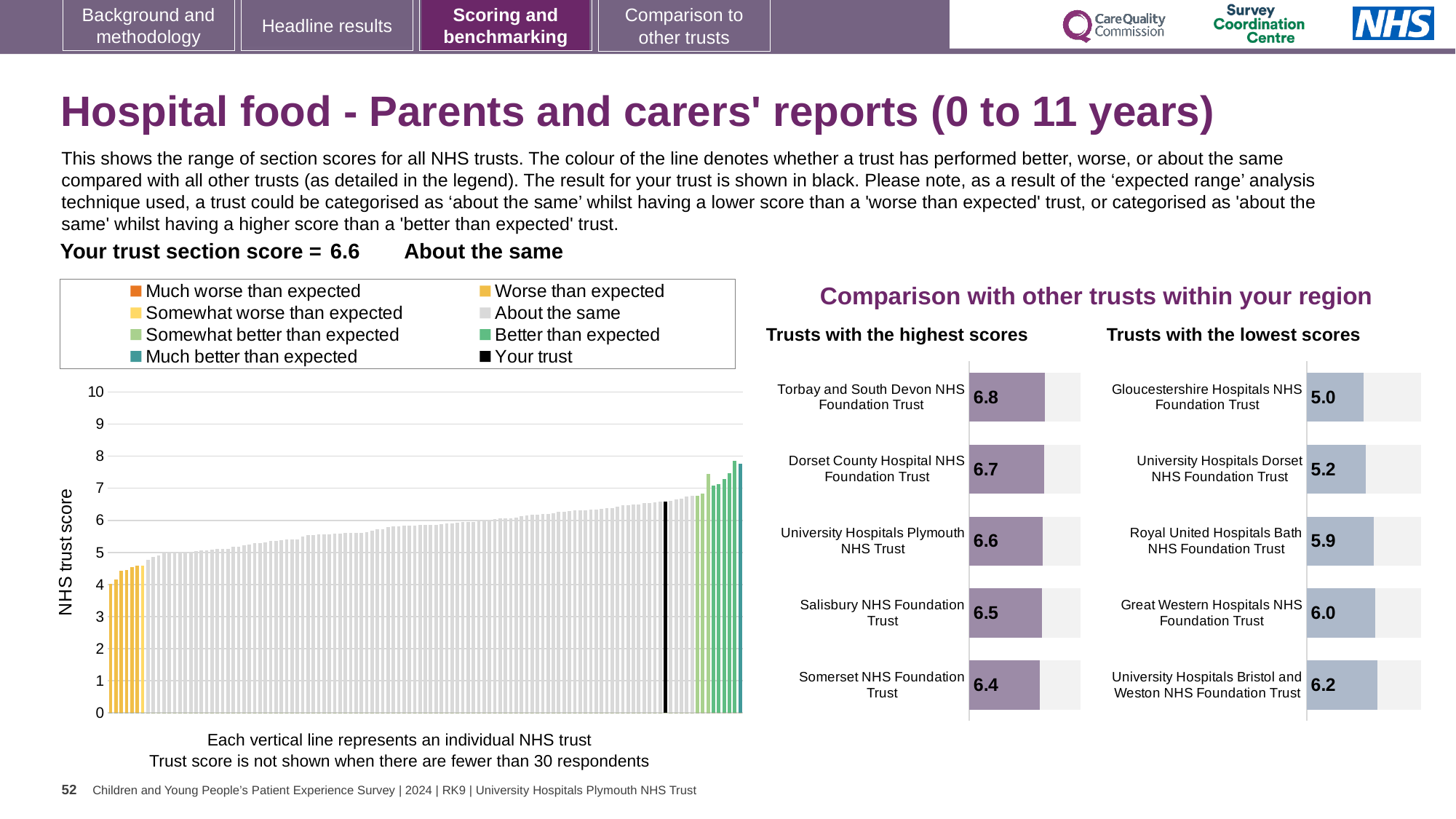
In the 'Trusts with the highest scores' chart, what is the difference between the scores of Torbay and South Devon NHS Foundation Trust and Somerset NHS Foundation Trust? 0.4 In the 'Trusts with the lowest scores' chart, which trust has the highest score? University Hospitals Bristol and Weston NHS Foundation Trust In the 'Trusts with the lowest scores' chart, which has the higher score: Royal United Hospitals Bath NHS Foundation Trust or Great Western Hospitals NHS Foundation Trust? Great Western Hospitals NHS Foundation Trust In the large chart on the left, is the value of the lowest bar greater or less than 5? less In the 'Trusts with the highest scores' chart, which trust has the lowest score? Somerset NHS Foundation Trust How many entries does the legend of the large chart on the left list? 8 How many trusts are shown in the 'Trusts with the lowest scores' chart? 5 In the 'Trusts with the highest scores' chart, what is the score for Torbay and South Devon NHS Foundation Trust? 6.8 In the 'Trusts with the lowest scores' chart, what is the difference between the scores of University Hospitals Bristol and Weston NHS Foundation Trust and Gloucestershire Hospitals NHS Foundation Trust? 1.2 What kind of chart is the large chart on the left showing NHS trust scores? Bar chart In the 'Trusts with the lowest scores' chart, what is the score for Gloucestershire Hospitals NHS Foundation Trust? 5.0 In the 'Trusts with the highest scores' chart, what is the score for Salisbury NHS Foundation Trust? 6.5